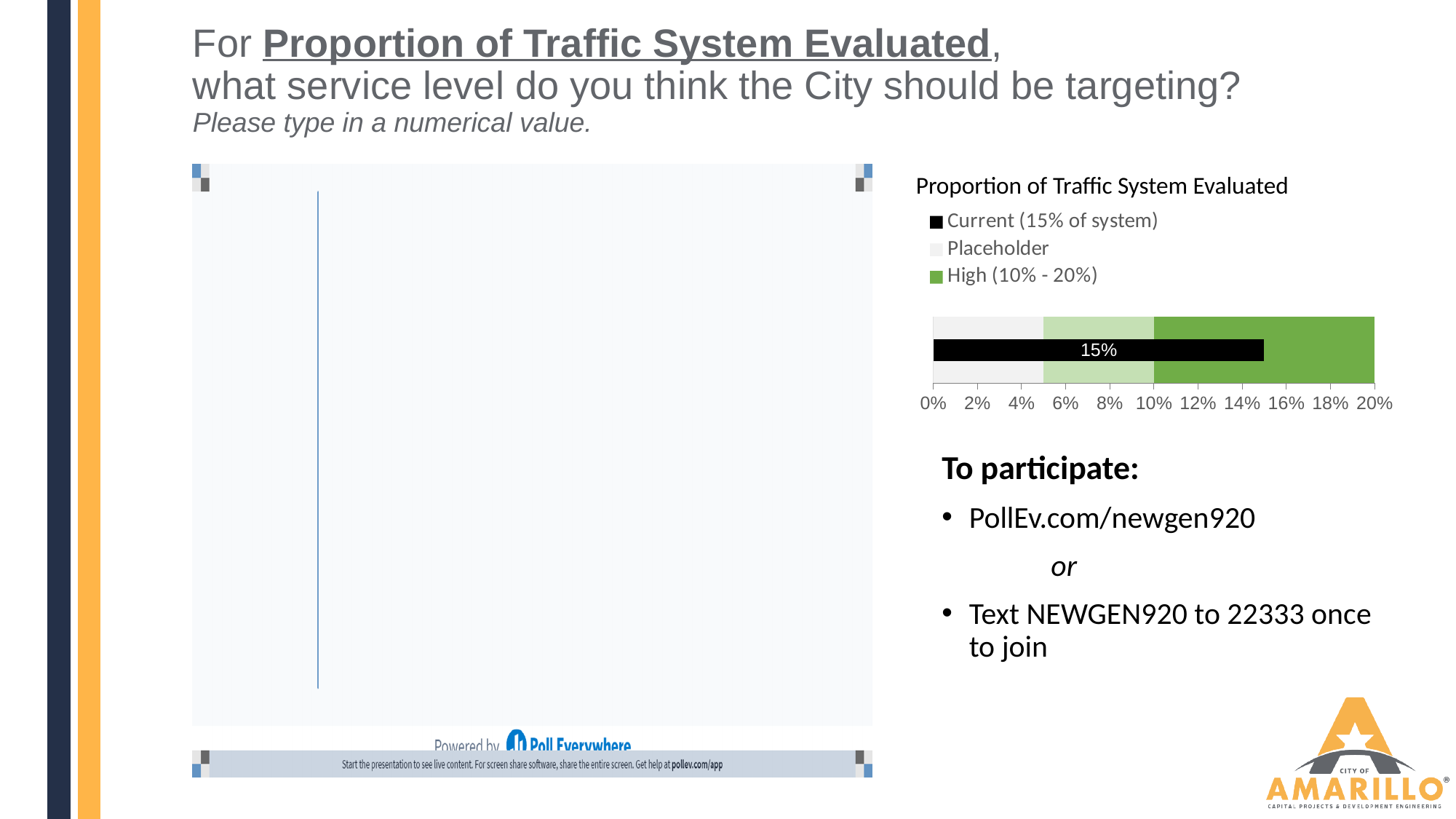
What is the title of the chart on the right side of the slide? Proportion of Traffic System Evaluated In the Proportion of Traffic System Evaluated chart, which legend series is shown in black? Current (15% of system) In the Proportion of Traffic System Evaluated chart, what value is printed on the black Current bar? 15% In the Proportion of Traffic System Evaluated chart, what range does the legend give for the High series? 10% - 20% In the Proportion of Traffic System Evaluated chart, is the value of the Current bar greater or less than 10%? greater What is the maximum value shown on the x axis of the Proportion of Traffic System Evaluated chart? 20% In the Proportion of Traffic System Evaluated chart, is the value of the Current bar greater or less than 16%? less In the Proportion of Traffic System Evaluated chart, what percentage of the system does the legend say is Current? 15% What kind of chart is the Proportion of Traffic System Evaluated chart? bar chart How many series does the legend of the Proportion of Traffic System Evaluated chart list? 3